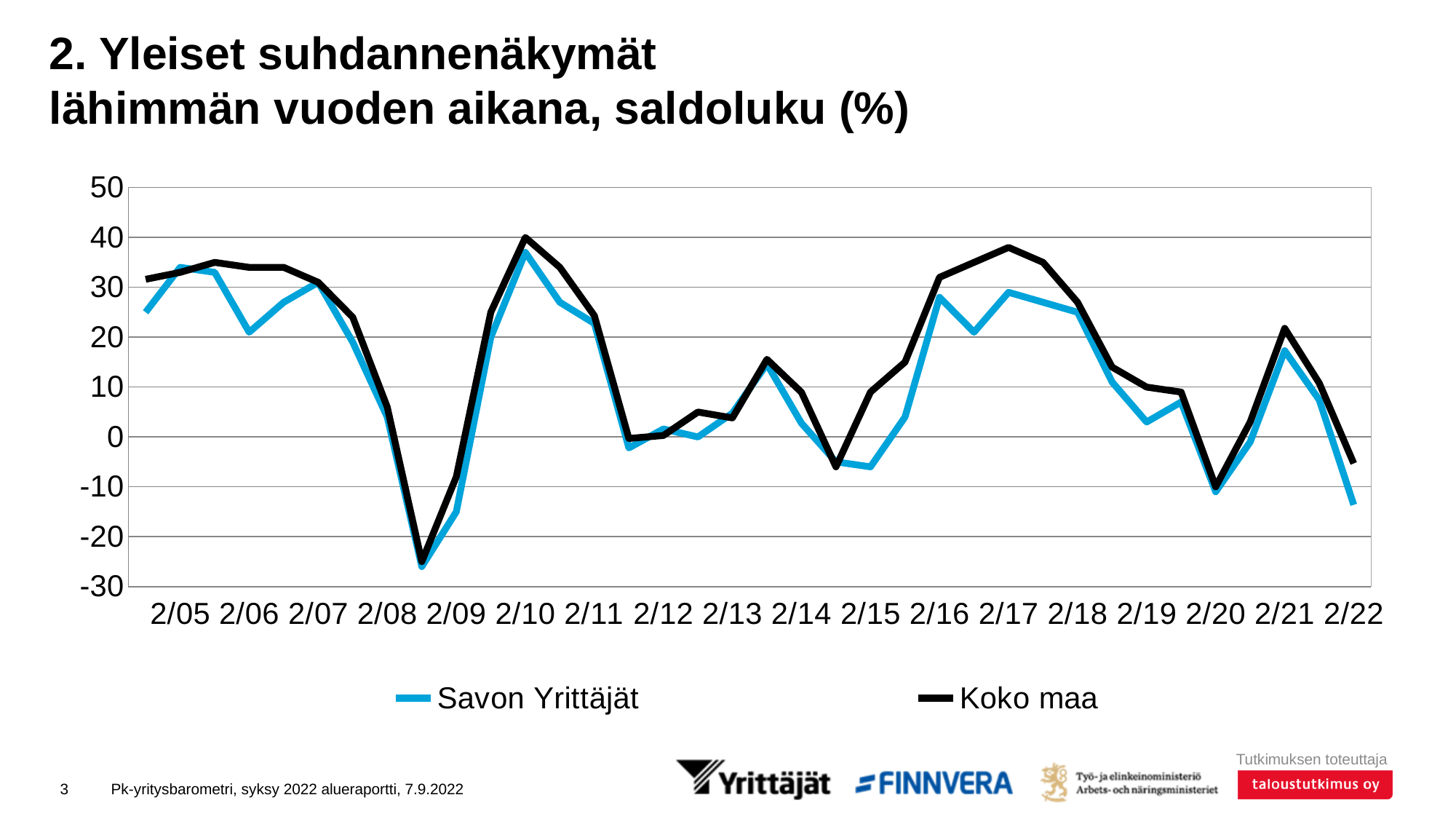
Is the value for Koko maa at 2/10 greater or less than 30? greater At which x-axis label does the Koko maa series reach its highest value? 2/10 Which colour is used for the Koko maa line? black Which two series are listed in the legend? Savon Yrittäjät and Koko maa How many series does the legend list? 2 At 2/22, which series has the higher value, Savon Yrittäjät or Koko maa? Koko maa Is the value for Koko maa at 2/22 greater or less than 0? less Is the value for Savon Yrittäjät at 2/22 greater or less than -10? less Do both series rise or fall between 2/21 and 2/22? fall How many year labels are shown on the x axis? 18 What kind of chart is shown on the slide? line chart